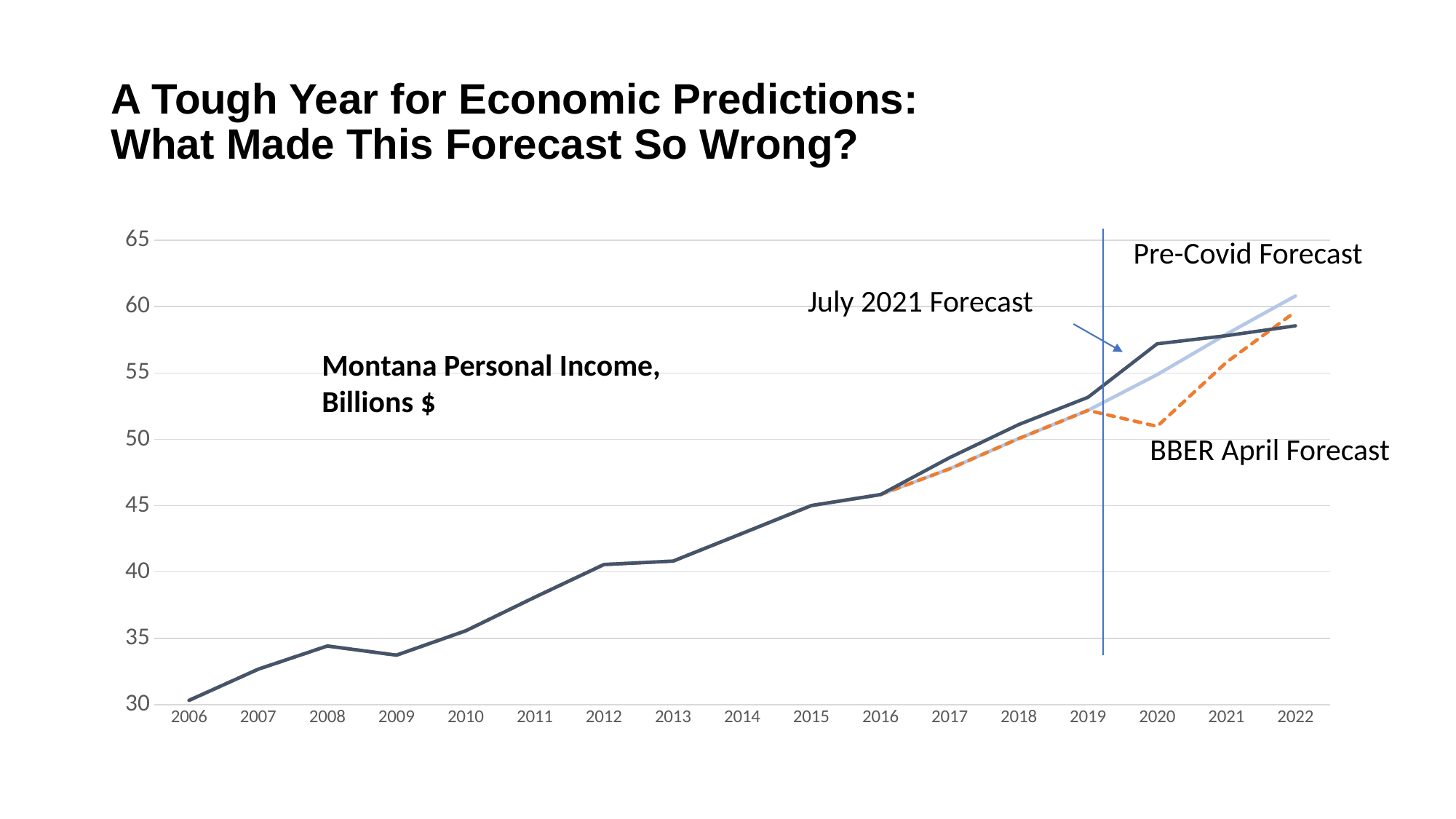
Which forecast is drawn as an orange dashed line? BBER April Forecast Which forecast shows the highest value in 2022? Pre-Covid Forecast Is the value for 2016 greater or less than 45? greater Is the BBER April Forecast value for 2020 greater or less than 55? less Does Montana personal income generally rise or fall from 2006 to 2019? rise How many years are labelled on the x axis of the chart? 17 Is the value for 2019 greater or less than 50? greater How many forecast series are labelled on the chart? 3 Which forecast shows the lowest value in 2020? BBER April Forecast What quantity does the chart say it plots, according to the label inside the plot area? Montana Personal Income, Billions $ What kind of chart is shown on the slide? line chart